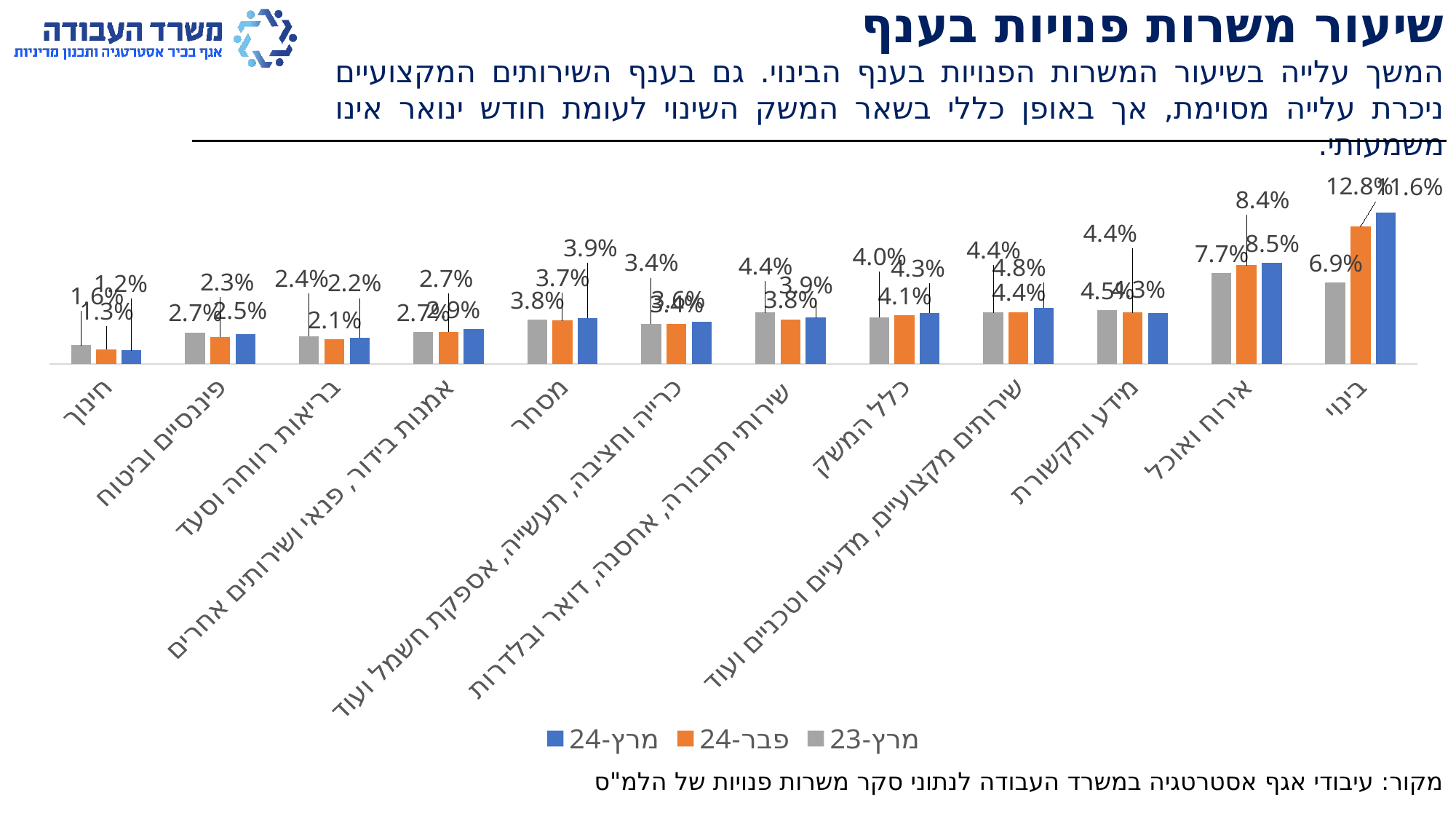
For שירותי תחבורה, אחסנה, דואר ובלדרות, which is larger: the מרץ-23 value or the מרץ-24 value? מרץ-23 How many industry categories are shown on the x axis? 12 What kind of chart is shown on the slide? bar chart Which category has the highest value in the מרץ-24 series? בינוי What is the value for בינוי in the פבר-24 series? 11.6% What is the value for כלל המשק in the מרץ-23 series? 4.0% How many series does the legend list? 3 Which category has the lowest value in the מרץ-23 series? חינוך What is the value for חינוך in the מרץ-24 series? 1.2% Which colour represents the מרץ-24 series in the legend? blue What is the difference between the פבר-24 and מרץ-23 values for בינוי? 4.7% What is the value for אירוח ואוכל in the מרץ-24 series? 8.5%